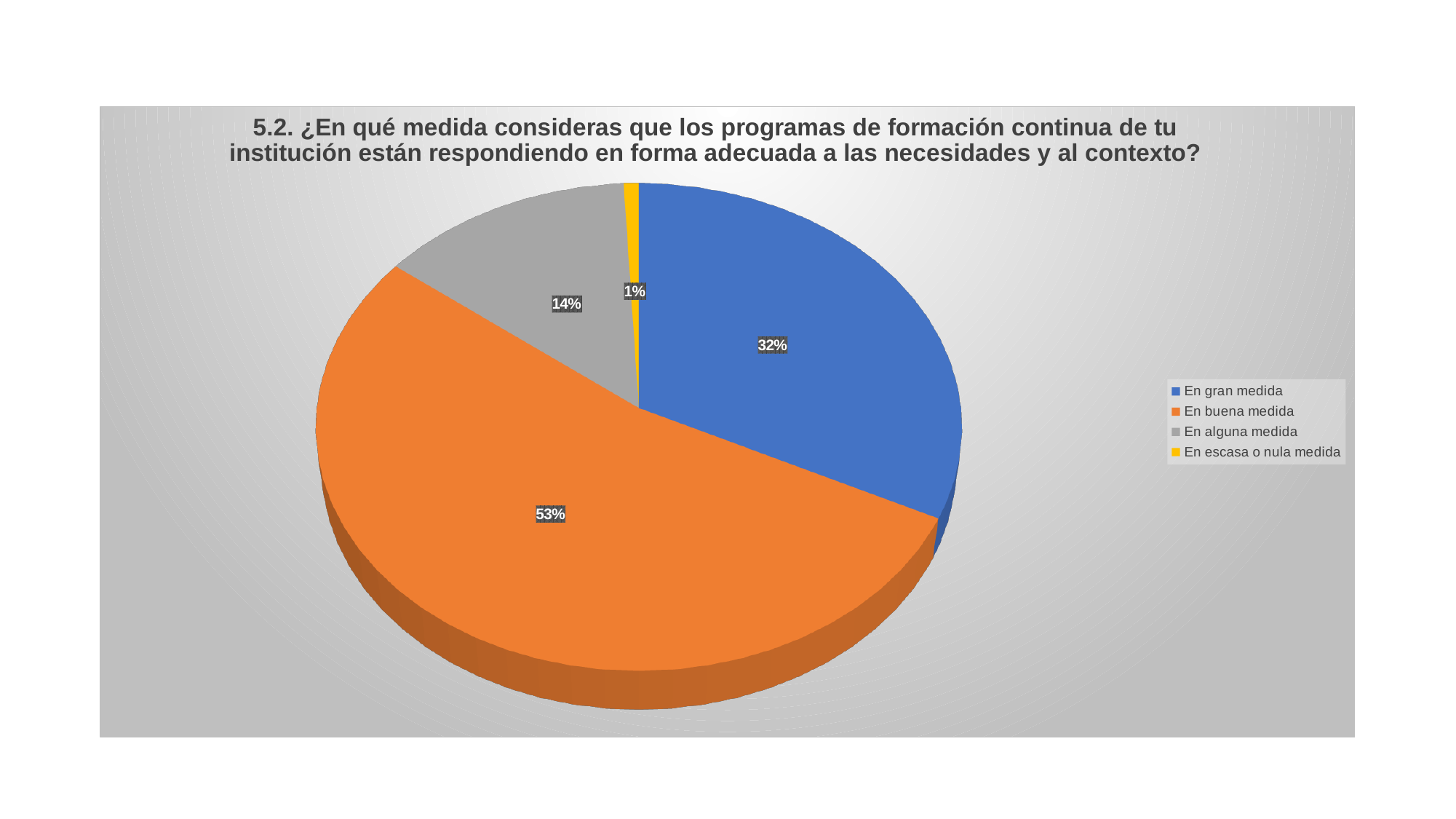
What is the difference in percentage points between "En alguna medida" and "En escasa o nula medida"? 13 What colour is the slice for "En alguna medida"? Grey What kind of chart is shown on the slide? Pie chart Which is larger, the slice for "En gran medida" or the slice for "En alguna medida"? En gran medida Which category has the largest slice of the pie? En buena medida What share of the pie does "En gran medida" represent? 32% What is the difference in percentage points between "En buena medida" and "En gran medida"? 21 What share of the pie does "En buena medida" represent? 53% How many categories does the pie chart show? 4 Which category has the smallest slice of the pie? En escasa o nula medida What share of the pie does "En alguna medida" represent? 14%